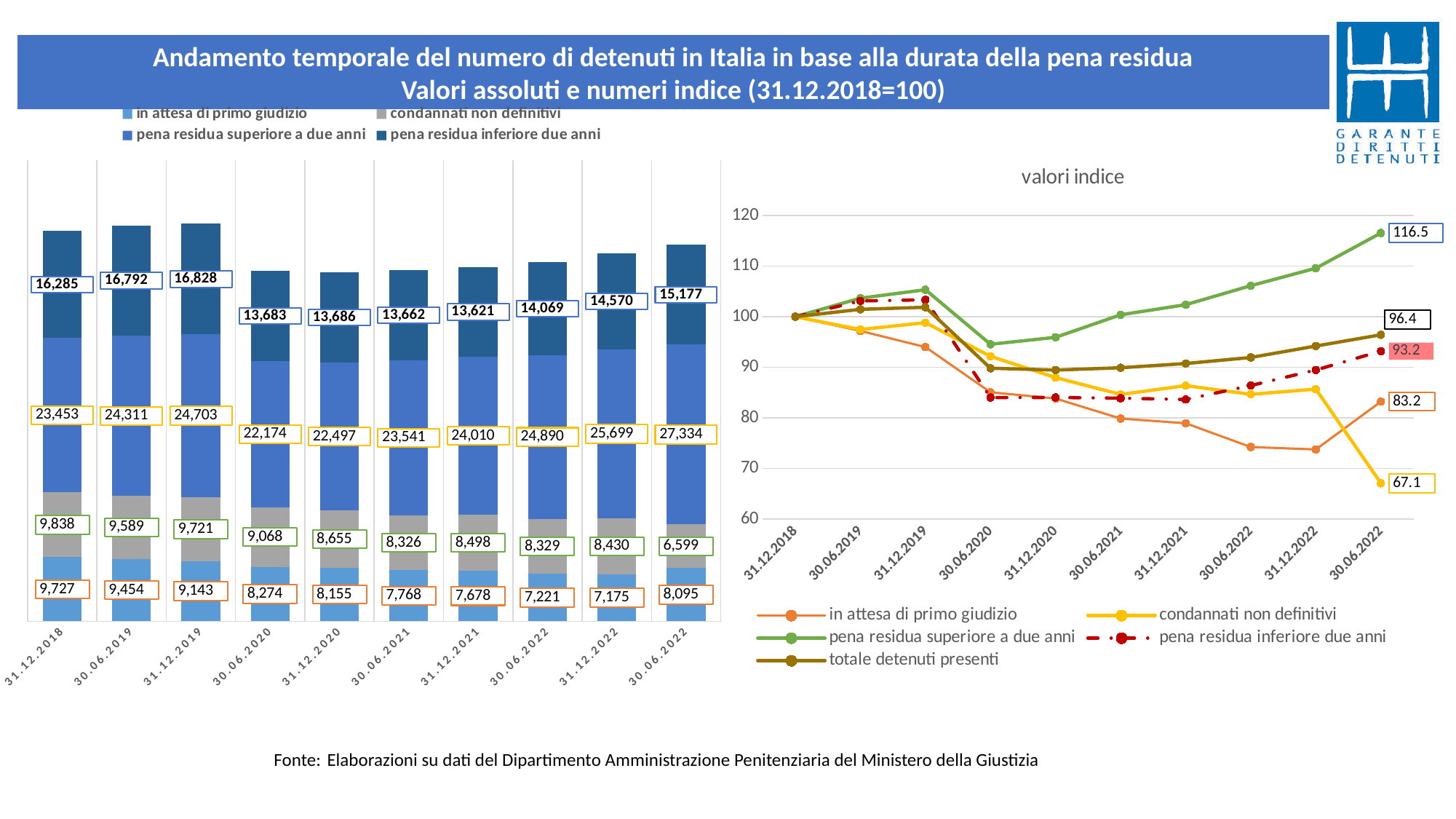
In the left stacked bar chart, at 31.12.2021, which is larger: 'in attesa di primo giudizio' or 'condannati non definitivi'? condannati non definitivi What kind of chart is the 'valori indice' chart on the right? line chart In the left stacked bar chart, how many dates are shown on the x axis? 10 In the left stacked bar chart, at which date is the value for 'pena residua inferiore due anni' highest? 31.12.2019 In the left stacked bar chart, what is the total of the stacked bar for 31.12.2018? 59,303 How many series does the legend of the 'valori indice' chart list? 5 In the left stacked bar chart, what is the value for 'in attesa di primo giudizio' at 31.12.2018? 9,727 In the left stacked bar chart, at which date is the value for 'condannati non definitivi' lowest? 30.06.2022 How many series does the legend of the left stacked bar chart list? 4